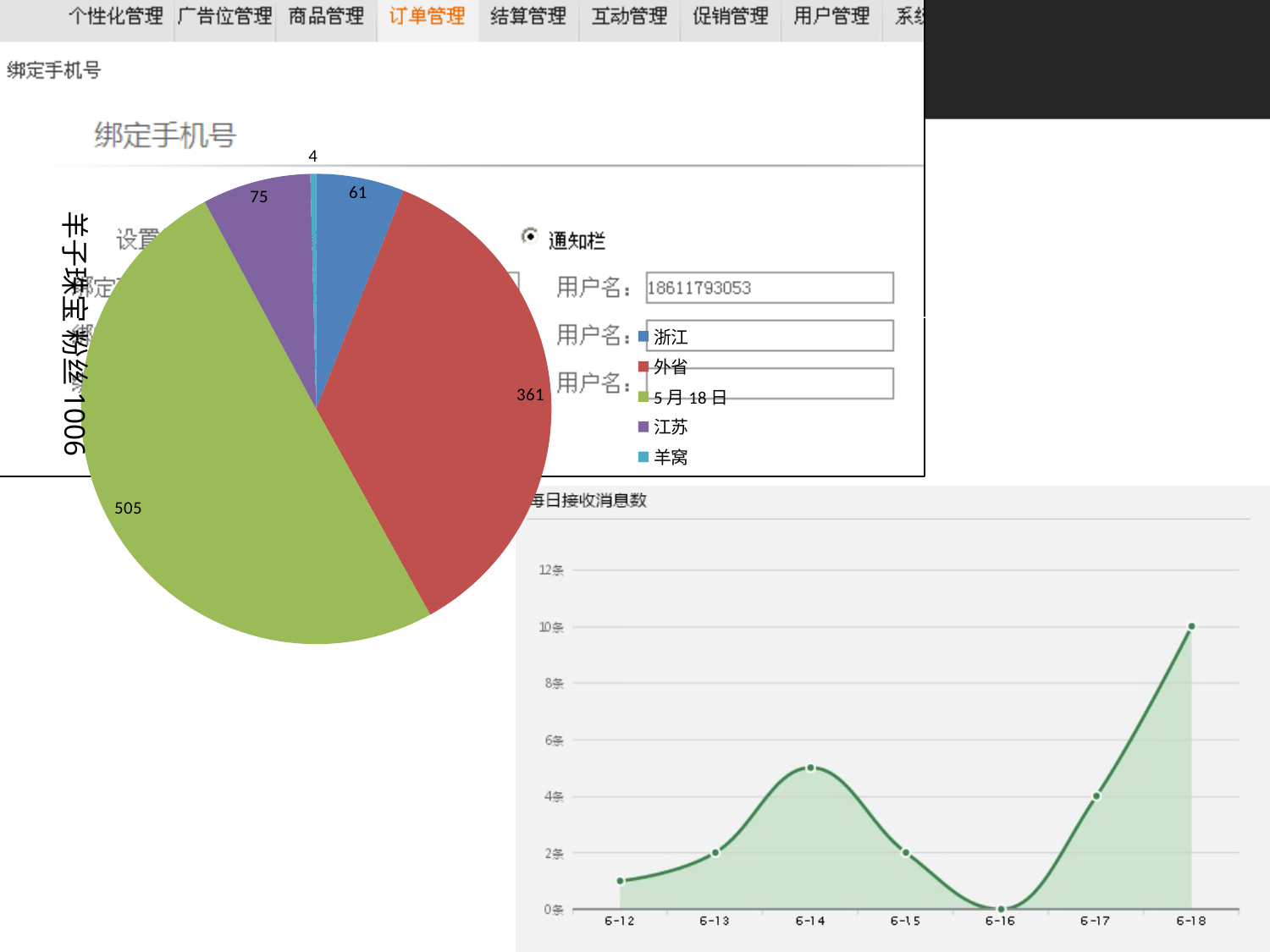
In the chart titled 每日接收消息数, is the value for 6-14 greater or less than 4条? greater How many categories does the pie chart's legend list? 5 What kind of chart is the chart titled 每日接收消息数? Line chart In the pie chart, what colour is the slice for 外省? Red In the pie chart, which is larger, 江苏 or 浙江? 江苏 In the pie chart, what is the value for 外省? 361 In the chart titled 每日接收消息数, what is the value for 6-18? 10条 In the pie chart, what is the difference between the values for 外省 and 浙江? 300 In the chart titled 每日接收消息数, which date has the lowest value? 6-16 In the pie chart, what is the value for 江苏? 75 In the pie chart, which category has the smallest slice? 羊窝 In the pie chart, which category has the largest slice? 5 月 18 日